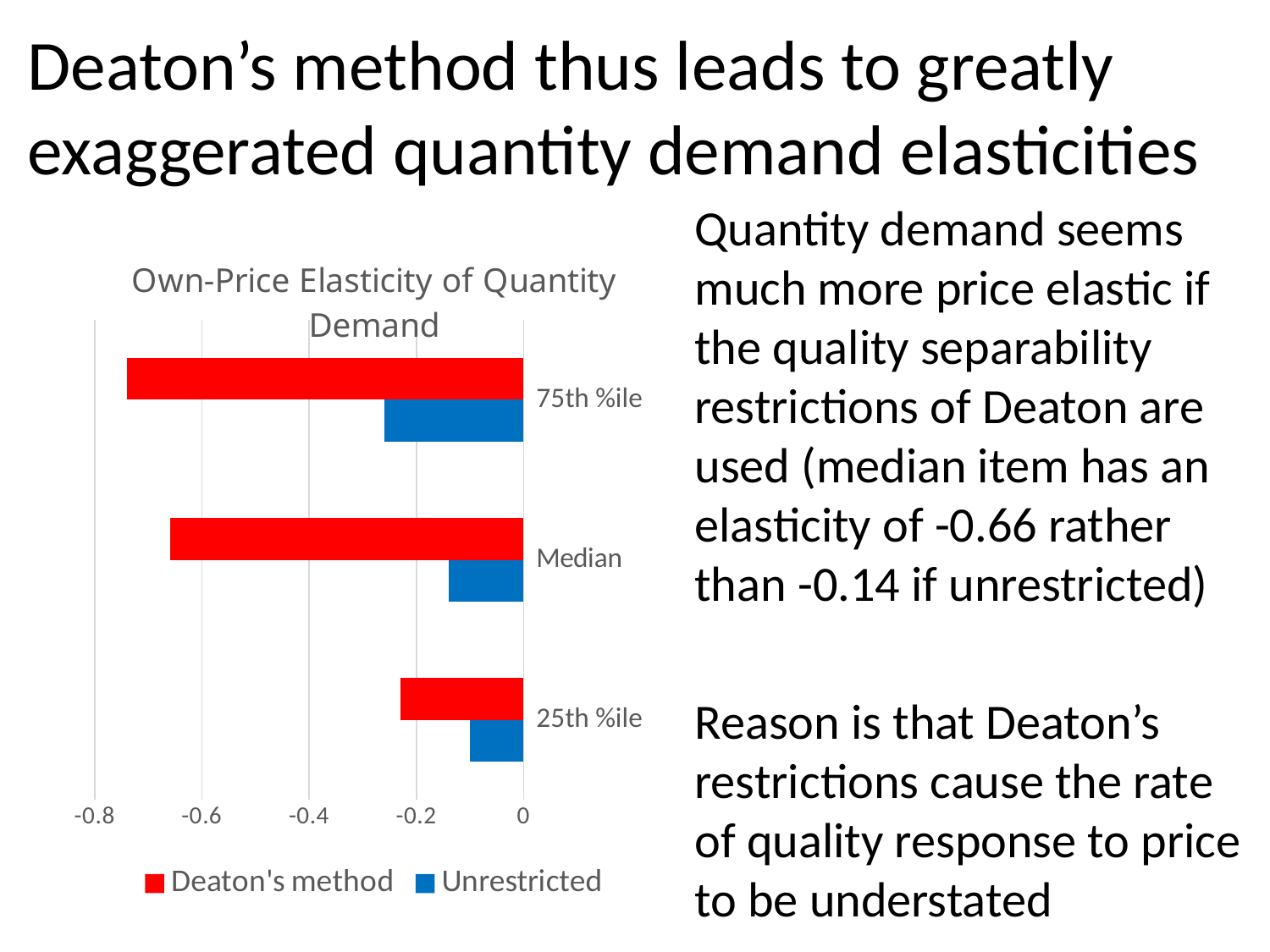
According to the slide, what is the own-price elasticity of the median item when unrestricted? -0.14 What type of chart is shown on the slide? Bar chart What is the title of the chart? Own-Price Elasticity of Quantity Demand Which category has the longest (most negative) Deaton's method bar? 75th %ile How many series does the chart legend list? 2 Is the Deaton's method value for 75th %ile greater or less than -0.6? less For the Median category, which series has the longer bar: Deaton's method or Unrestricted? Deaton's method Is the Unrestricted value for 25th %ile greater or less than -0.2? greater How many categories are shown on the chart? 3 Is the Unrestricted value for 75th %ile greater or less than -0.2? less According to the slide, what is the own-price elasticity of the median item under Deaton's method? -0.66 Which colour represents Deaton's method in the chart? Red